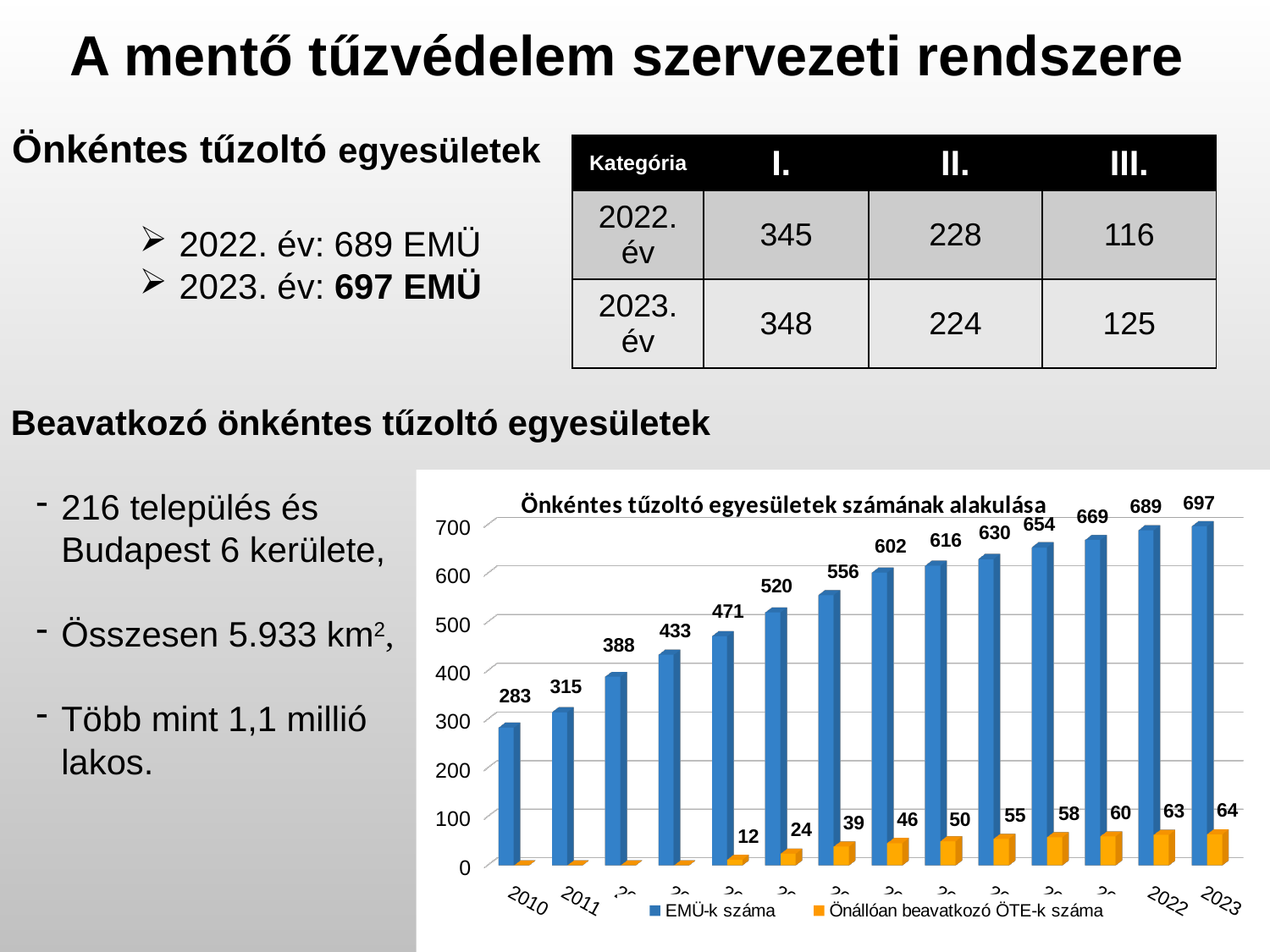
Does EMÜ-k száma rise or fall from 2010 to 2023? rise How many series does the chart legend list? 2 By how much did EMÜ-k száma increase from 2022 to 2023? 8 What is the value of EMÜ-k száma for 2023? 697 Which year has the highest value of EMÜ-k száma? 2023 What is the value of Önállóan beavatkozó ÖTE-k száma for 2023? 64 What is the title of the chart? Önkéntes tűzoltó egyesületek számának alakulása What is the difference in EMÜ-k száma between 2011 and 2010? 32 What kind of chart is shown on the slide? bar chart What is the value of Önállóan beavatkozó ÖTE-k száma for 2022? 63 What is the value of EMÜ-k száma for 2010? 283 Which year has the lowest value of EMÜ-k száma? 2010